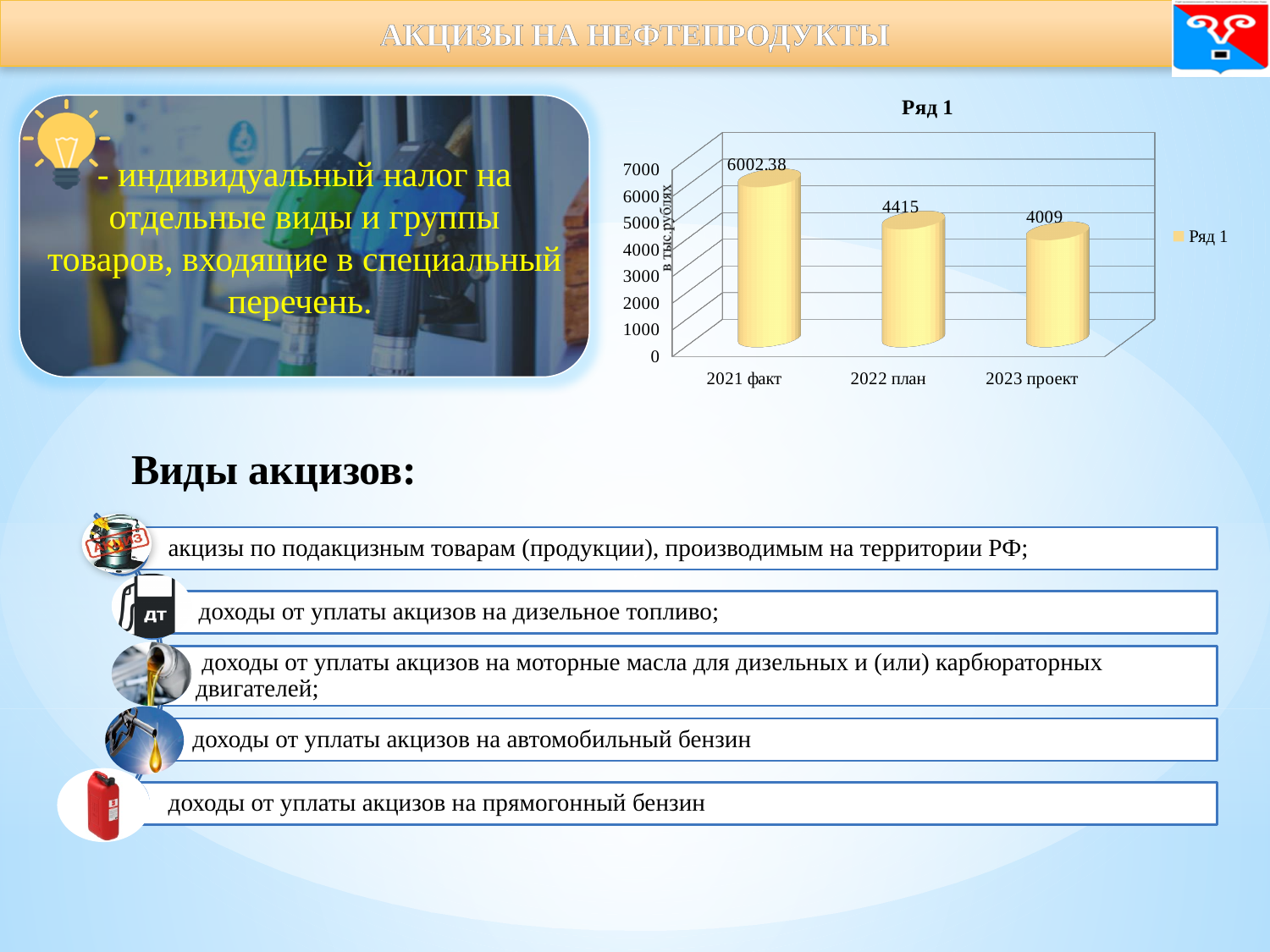
How many categories are shown on the x axis of the chart? 3 Which category has the lowest value? 2023 проект What is the difference between the values for 2022 план and 2023 проект? 406 Which category has the highest value? 2021 факт What is the value for 2022 план? 4415 Is the value for 2022 план greater or less than 5000? less Do the values rise or fall from 2021 факт to 2023 проект? fall What is the difference between the values for 2021 факт and 2022 план? 1587.38 What kind of chart is shown on the slide? bar chart Which is larger, the value for 2021 факт or the value for 2023 проект? 2021 факт What is the value for 2023 проект? 4009 What is the value for 2021 факт? 6002.38